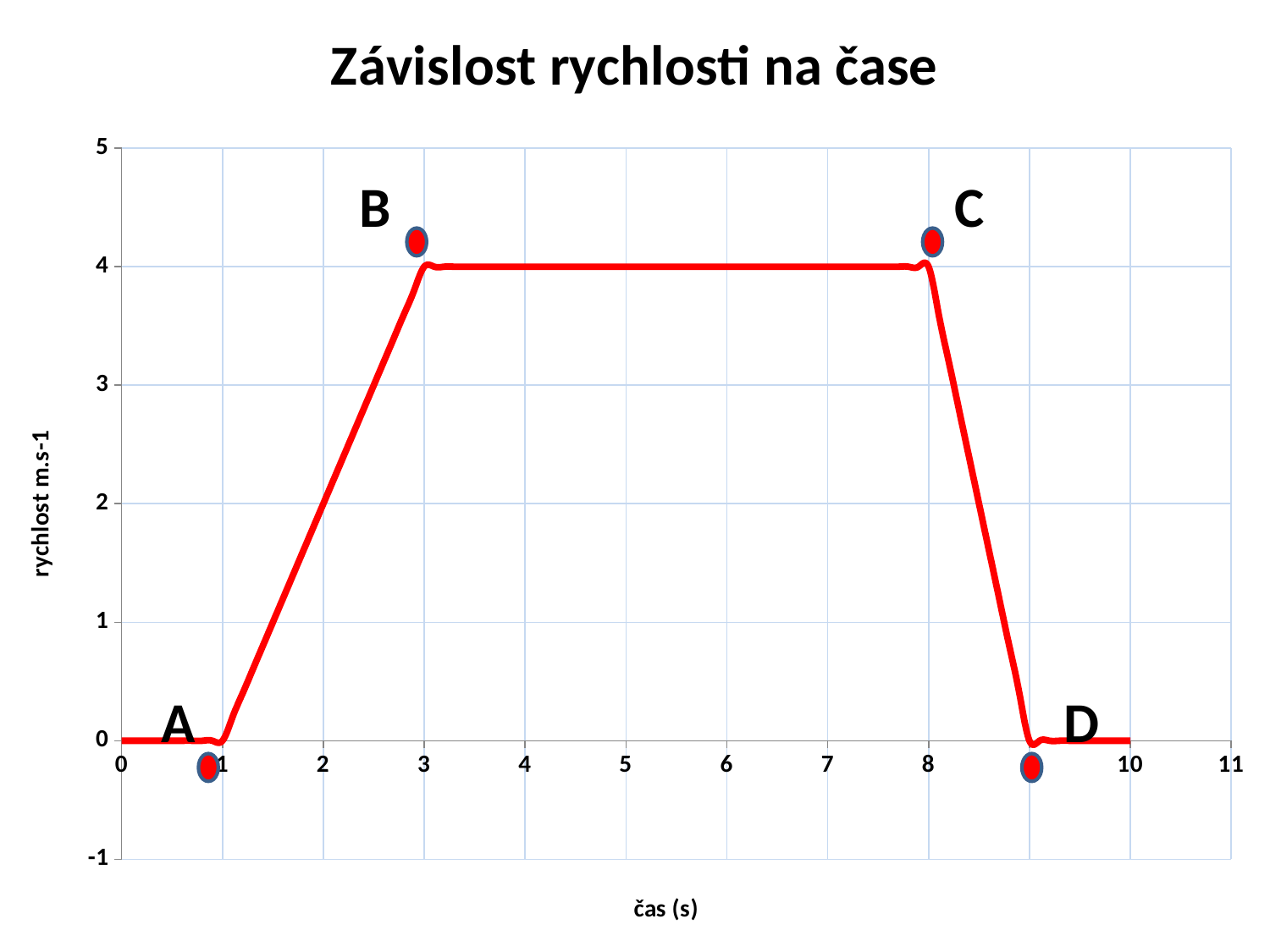
What is the label of the x axis? čas (s) What is the title of the chart? Závislost rychlosti na čase Does the line rise or fall between time 1 s and time 3 s? rise What is the value of the line at time 10 s? 0 What is the value of the line at time 3 s (point B)? 4 What kind of chart is shown on the slide? line chart Which is larger, the value at time 5 s or the value at time 10 s? time 5 s Is the value of the line at time 2 s greater or less than 1? greater How many labeled points (letters) are marked on the line? 4 What is the value of the line at time 5 s? 4 What is the highest value the line reaches? 4 Does the line rise or fall between time 8 s and time 9 s? fall